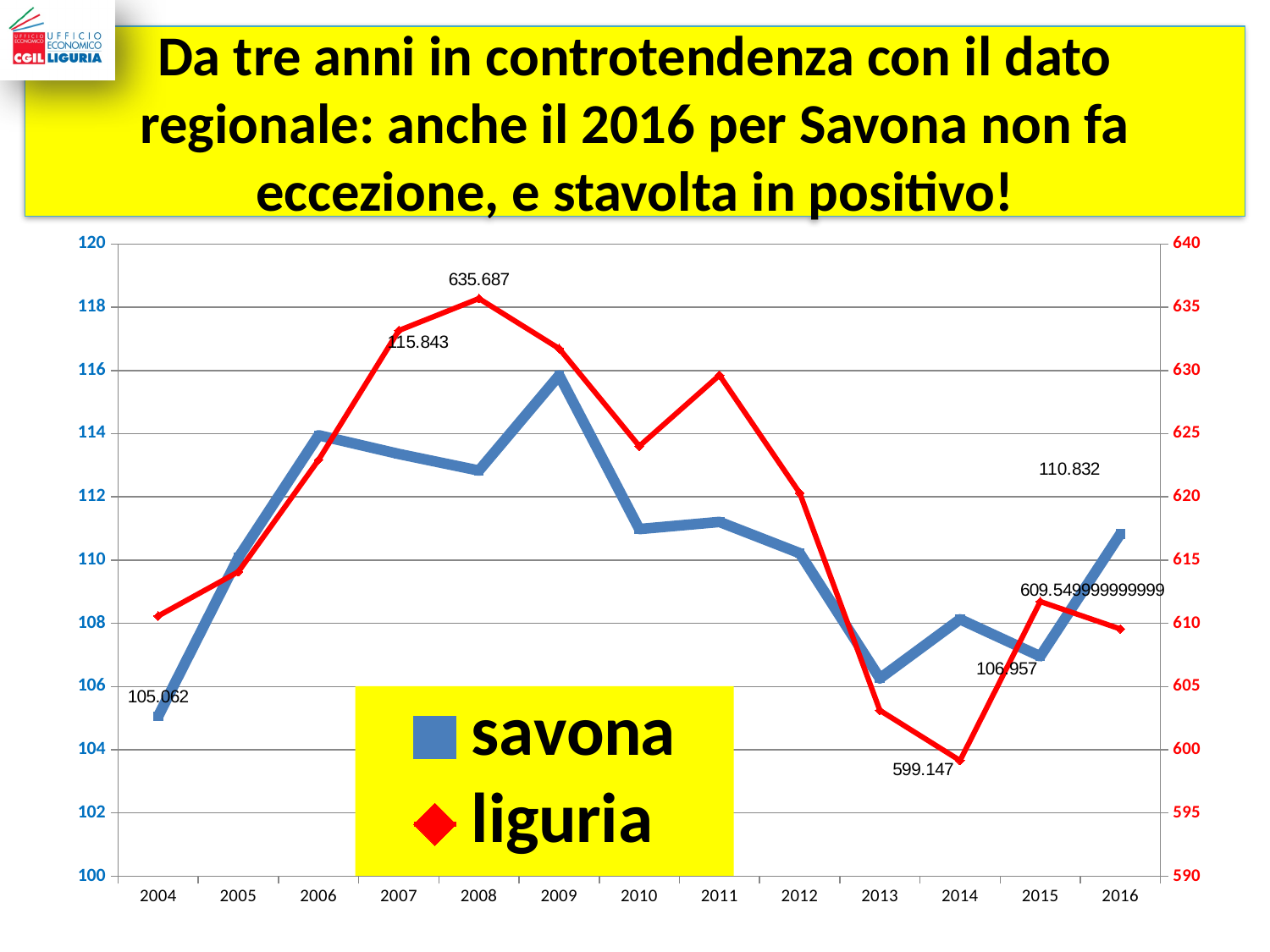
How many series does the legend list? 2 What is the value for savona in 2016? 110.832 Does the liguria series rise or fall from 2011 to 2014? fall Is the savona value for 2006 greater or less than 112? greater What kind of chart is shown on the slide? line chart In which year does the liguria series reach its lowest value? 2014 What is the value for liguria in 2008? 635.687 How many years are shown on the x axis? 13 What is the value for liguria in 2014? 599.147 What is the difference between the savona values for 2016 and 2015? 3.875 In which year does the savona series reach its highest value? 2009 What is the value for savona in 2004? 105.062